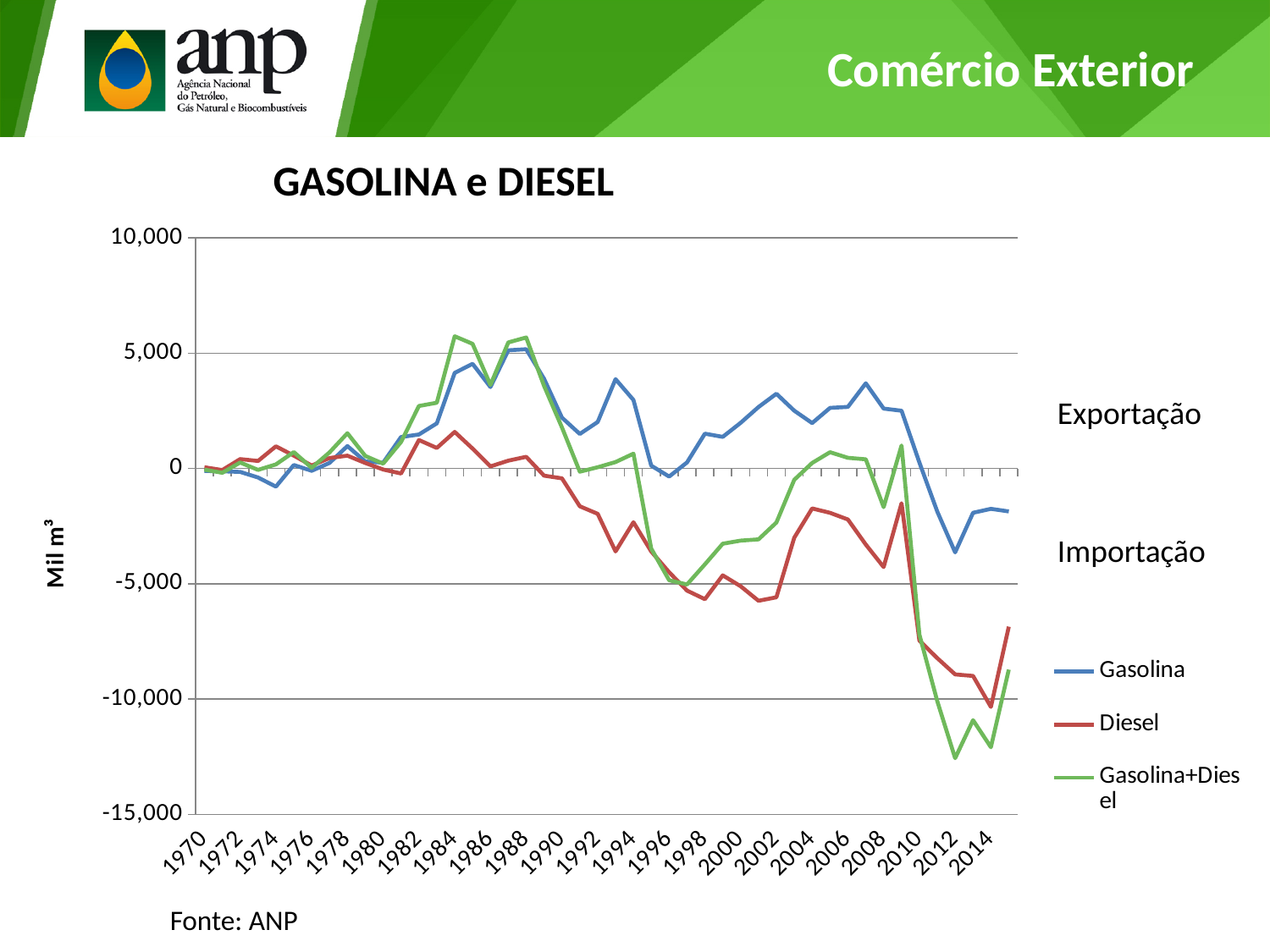
How many series does the legend list? 3 What kind of chart is shown on the slide? Line chart Is the value for Gasolina+Diesel in 2012 greater or less than -10,000? less Is the value for Gasolina+Diesel in 1984 greater or less than 5,000? greater Is the value for Diesel in 2012 greater or less than -10,000? greater In 2012, which series has the higher value, Gasolina or Diesel? Gasolina Does the Gasolina+Diesel line rise or fall between 2008 and 2012? Fall Which series reaches the lowest value on the chart? Gasolina+Diesel What is the title of the chart? GASOLINA e DIESEL What is the label on the vertical axis of the chart? Mil m³